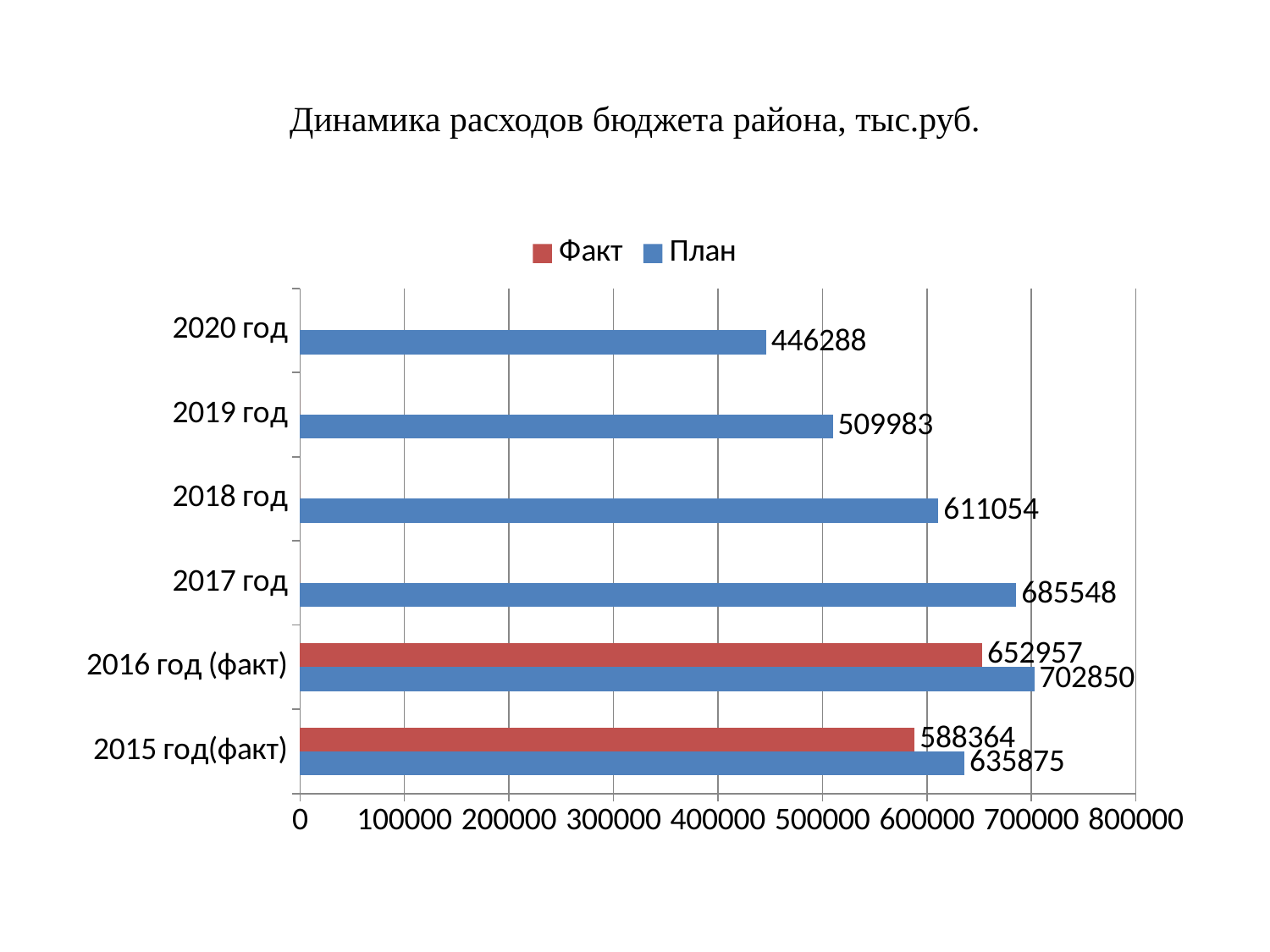
What is the План value for 2020 год? 446288 Which is larger: the План value for 2019 год or the Факт value for 2015 год(факт)? Факт value for 2015 год(факт) What type of chart is shown on the slide? Bar chart How many series does the legend list? 2 What is the difference between the План values for 2017 год and 2018 год? 74494 What is the План value for 2015 год(факт)? 635875 Which category has the highest План value? 2016 год (факт) Which category has the lowest План value? 2020 год What is the difference between the План and Факт values for 2015 год(факт)? 47511 What is the Факт value for 2016 год (факт)? 652957 How many categories are shown on the vertical axis? 6 Is the План value for 2018 год greater or less than 600000? greater